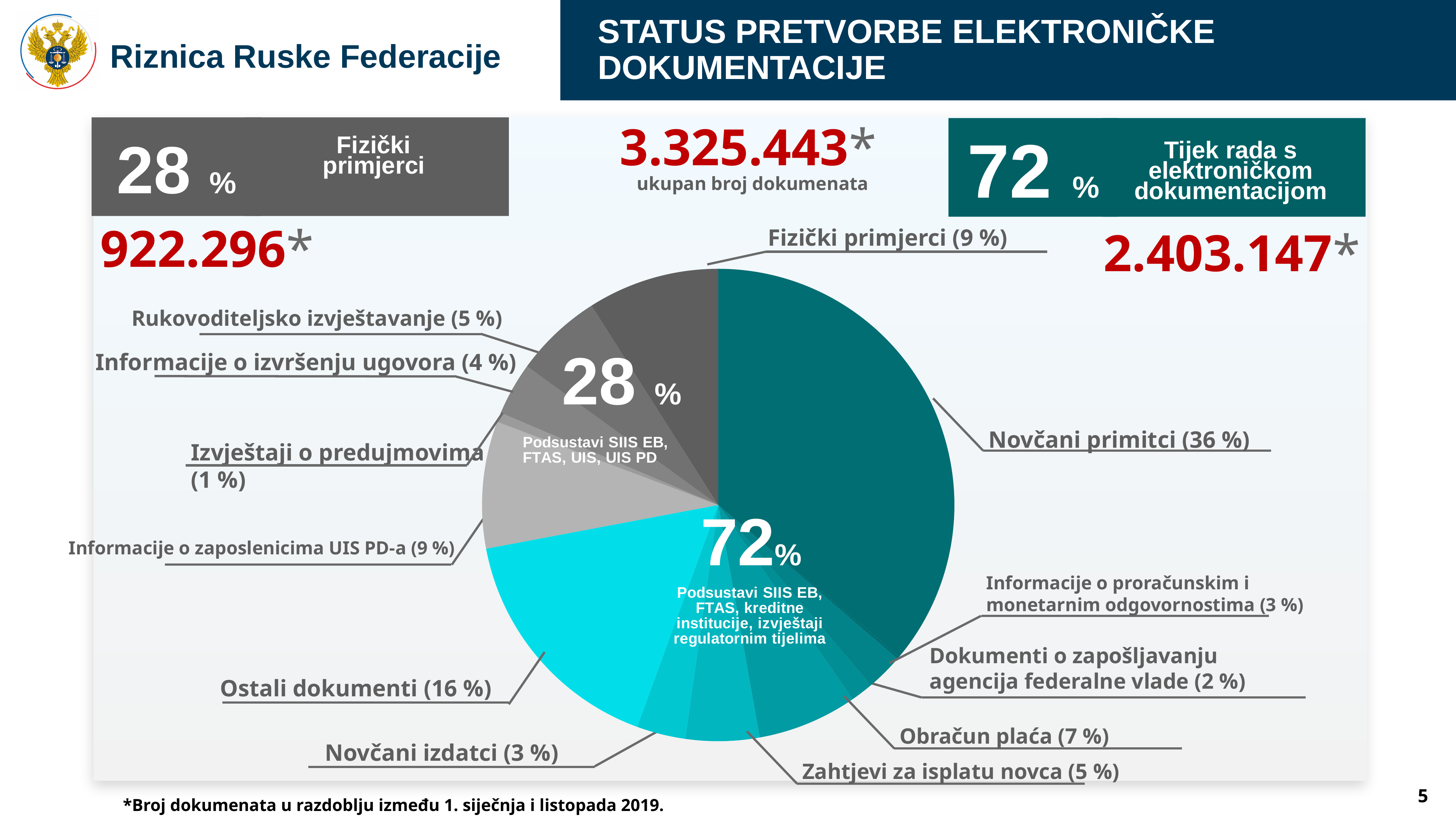
What share of the pie does Novčani primitci represent? 36 % What kind of chart is shown on the slide? pie chart Which slice of the pie is the smallest? Izvještaji o predujmovima What is the difference in percentage points between Novčani primitci and Ostali dokumenti? 20 Which slice of the pie is the largest? Novčani primitci What share of the pie does Ostali dokumenti represent? 16 % What percentage is shown for Informacije o zaposlenicima UIS PD-a? 9 % Which is larger: Rukovoditeljsko izvještavanje or Informacije o izvršenju ugovora? Rukovoditeljsko izvještavanje What percentage is shown for Obračun plaća? 7 % What total number of documents (ukupan broj dokumenata) is shown above the pie chart? 3.325.443